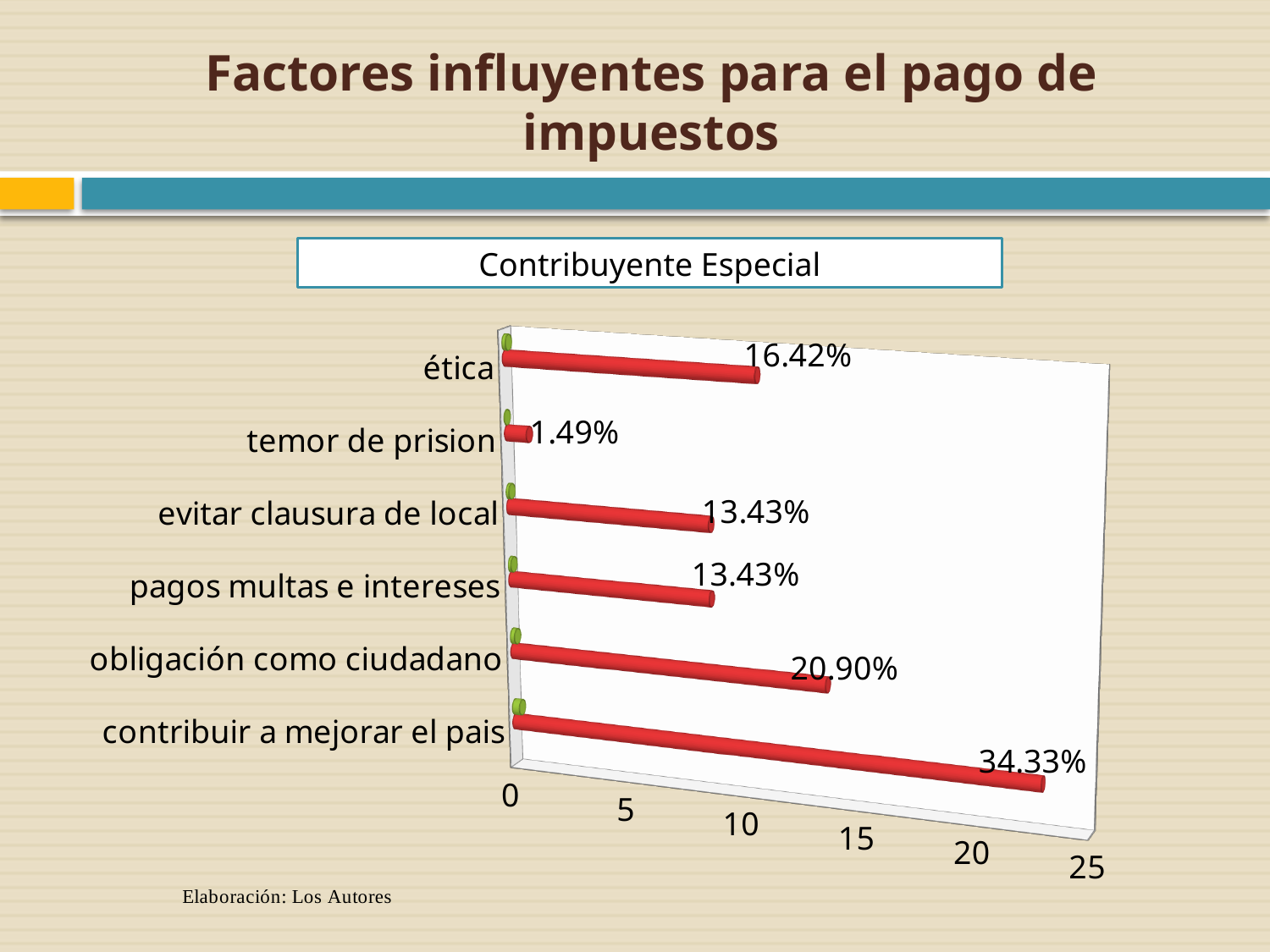
What is the title of the chart on the slide? Contribuyente Especial What is the value for 'obligación como ciudadano' in the Contribuyente Especial chart? 20.90% Which is larger, the value for 'ética' or the value for 'evitar clausura de local'? ética What is the value for 'contribuir a mejorar el pais' in the Contribuyente Especial chart? 34.33% What is the value for 'ética' in the Contribuyente Especial chart? 16.42% What is the value for 'temor de prision' in the Contribuyente Especial chart? 1.49% How many categories are shown in the Contribuyente Especial chart? 6 What is the difference between the values for 'contribuir a mejorar el pais' and 'obligación como ciudadano'? 13.43% Which category has the lowest value in the Contribuyente Especial chart? temor de prision What is the difference between the values for 'ética' and 'temor de prision'? 14.93% What kind of chart is shown on the slide? bar chart Which category has the highest value in the Contribuyente Especial chart? contribuir a mejorar el pais